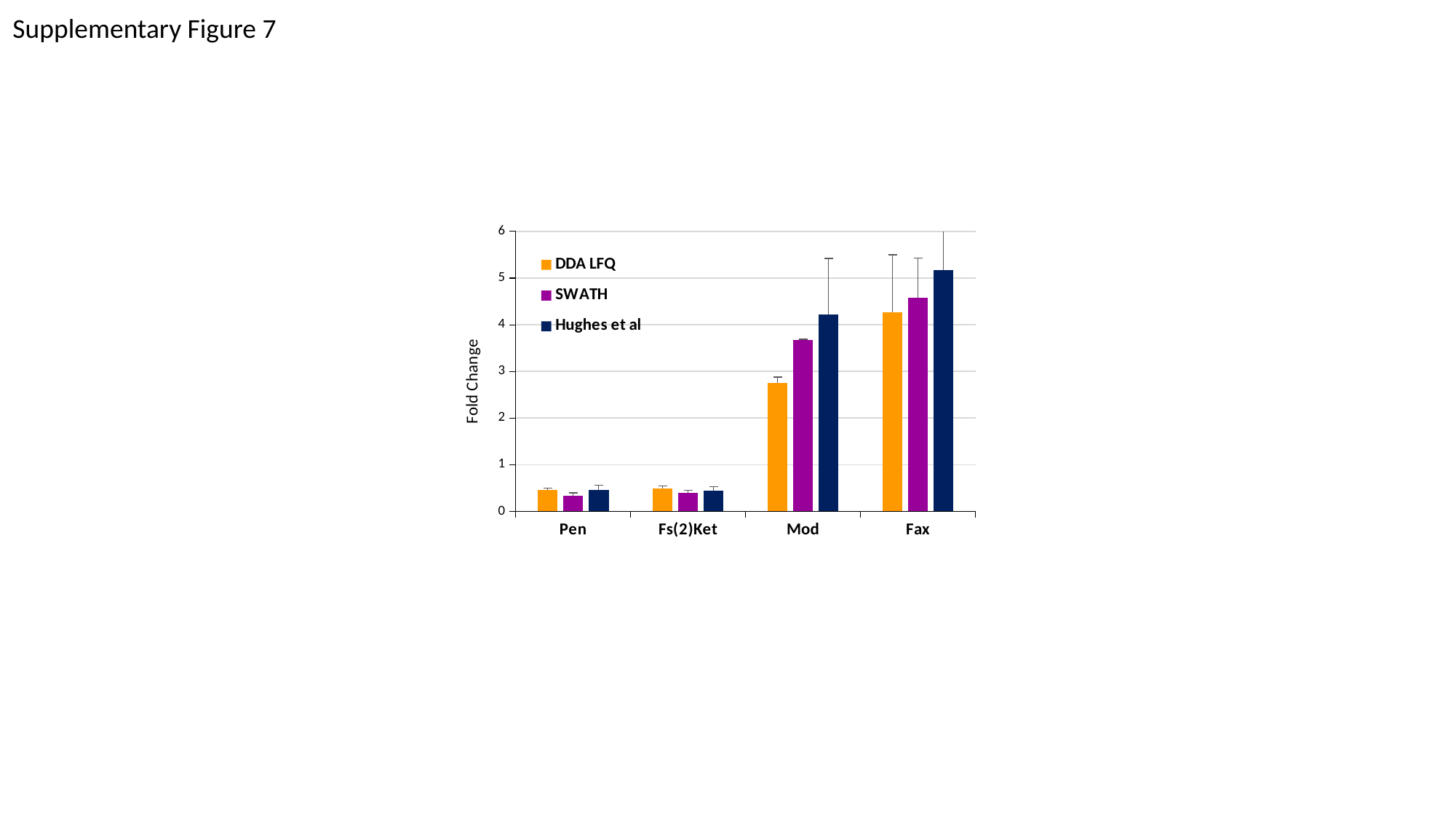
How many series does the legend list? 3 For Fax, which is larger: the Hughes et al value or the DDA LFQ value? Hughes et al What is the label of the y axis? Fold Change Is the DDA LFQ value for Mod greater or less than 3? less How many categories are shown on the x axis? 4 Which category has the lowest SWATH value? Pen For Mod, which is larger: the SWATH value or the DDA LFQ value? SWATH Which category has the highest Hughes et al value? Fax Which series is shown in orange in the legend? DDA LFQ What kind of chart is shown on the slide? bar chart Is the Hughes et al value for Fax greater or less than 5? greater Is the SWATH value for Pen greater or less than 1? less